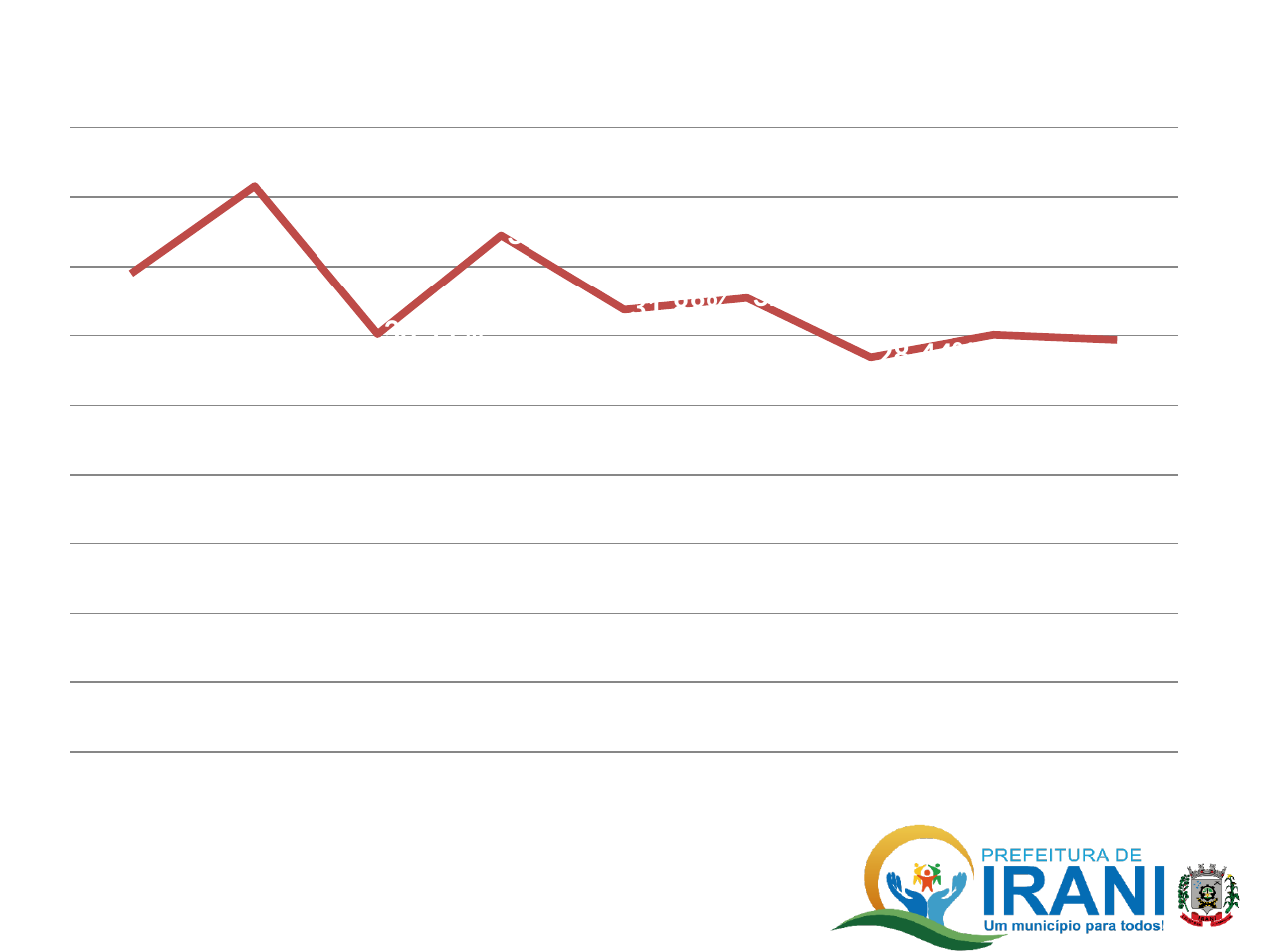
What kind of chart is shown on the slide? line chart Counting from the left, which point on the line is the highest? the second point What colour is the line plotted on the chart? red How many data points does the line on the chart have? 9 Is the last point of the line higher or lower than the first point? lower Overall, do the values on the chart rise or fall from left to right? fall Counting from the left, which point on the line is the lowest? the seventh point